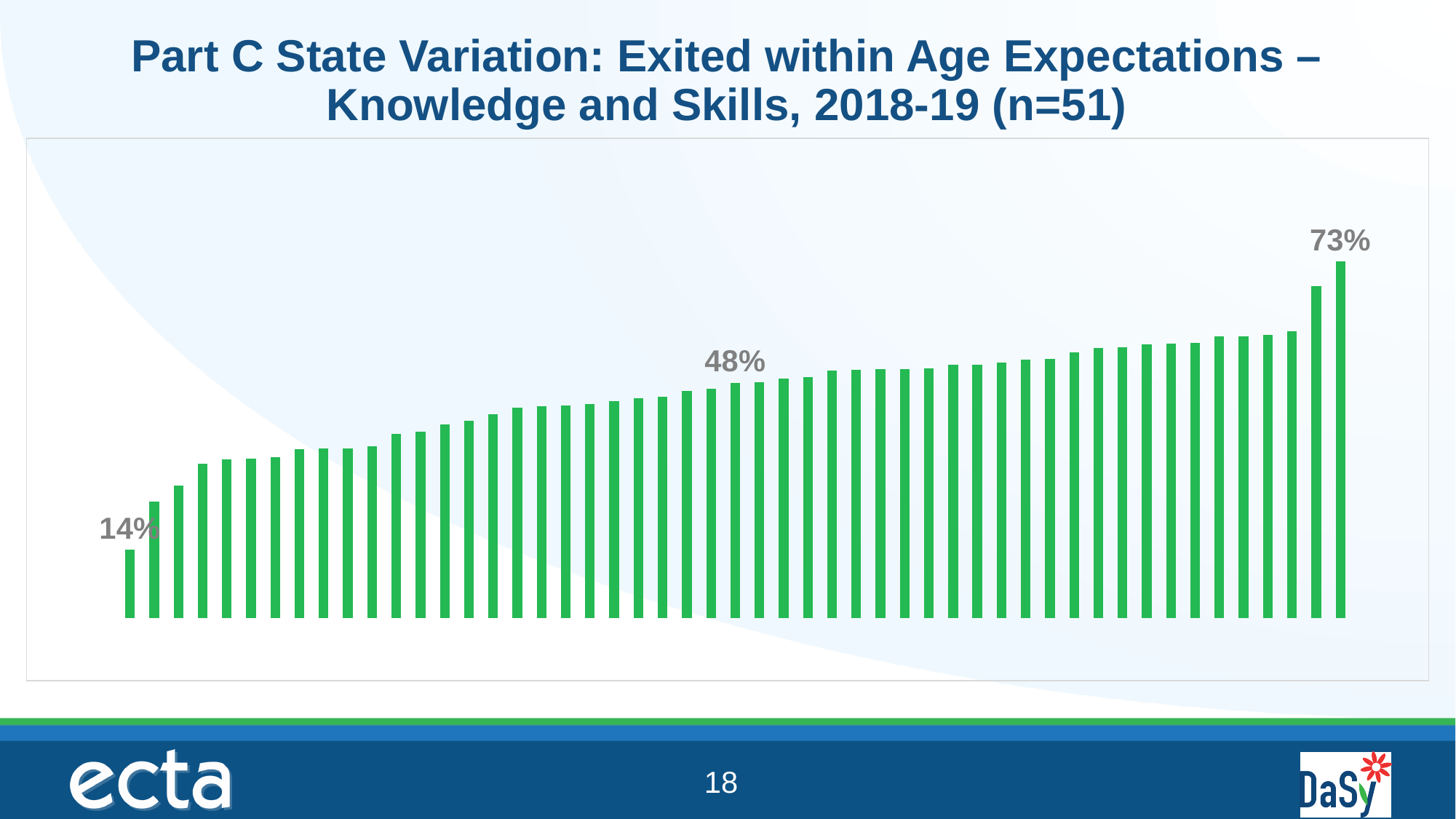
What is the value of the shortest bar in the chart? 14% What is the difference between the highest labelled value (73%) and the lowest labelled value (14%)? 59 percentage points What kind of chart is shown on the slide? bar chart What colour are the bars in the chart? green Is the value of the tallest bar greater or less than 50%? greater Which is larger, the value labelled 48% or the value labelled 73%? 73% How many states (bars) are represented in the chart, according to the title? 51 Do the bar values rise or fall from left to right across the chart? rise What is the value of the tallest bar in the chart? 73% Is the value of the shortest bar greater or less than 20%? less What value is labelled on the bar in the middle of the chart? 48% What is the title of the slide containing the chart? Part C State Variation: Exited within Age Expectations – Knowledge and Skills, 2018-19 (n=51)